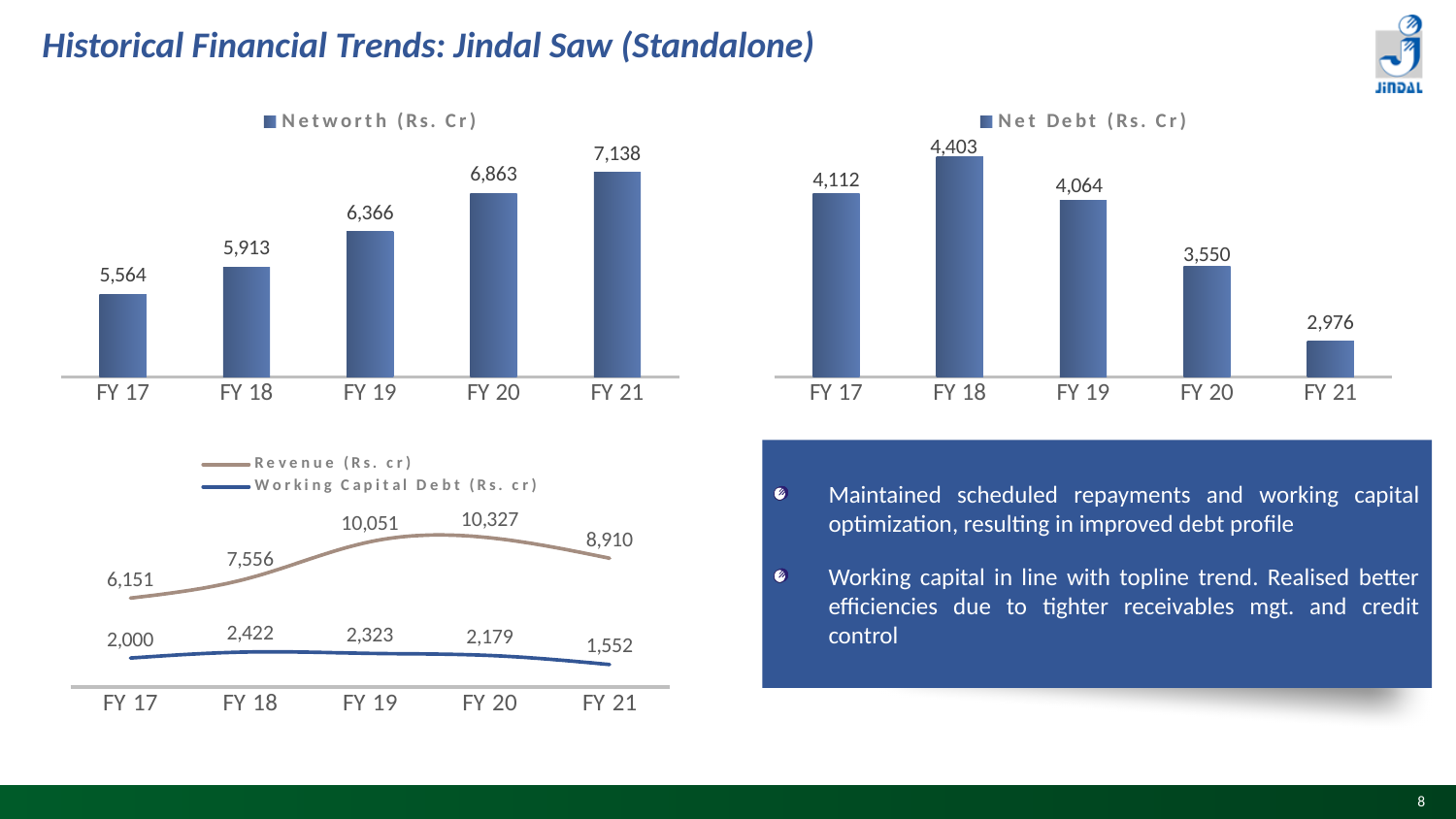
In the Networth (Rs. Cr) chart, what is the difference between FY 21 and FY 17? 1,574 In the bottom-left chart, what is the Working Capital Debt (Rs. cr) value for FY 21? 1,552 In the Networth (Rs. Cr) chart, what is the value for FY 20? 6,863 In the Net Debt (Rs. Cr) chart, which fiscal year has the lowest value? FY 21 In the Networth (Rs. Cr) chart, which fiscal year has the highest value? FY 21 In the Net Debt (Rs. Cr) chart, how many fiscal years are shown? 5 In the bottom-left chart, what is the Revenue (Rs. cr) value for FY 19? 10,051 In the Networth (Rs. Cr) chart, do the values rise or fall from FY 17 to FY 21? rise What kind of chart is the Net Debt (Rs. Cr) chart? bar chart In the Net Debt (Rs. Cr) chart, what is the difference between FY 19 and FY 20? 514 In the bottom-left chart, how many series does the legend list? 2 In the Net Debt (Rs. Cr) chart, what is the value for FY 18? 4,403